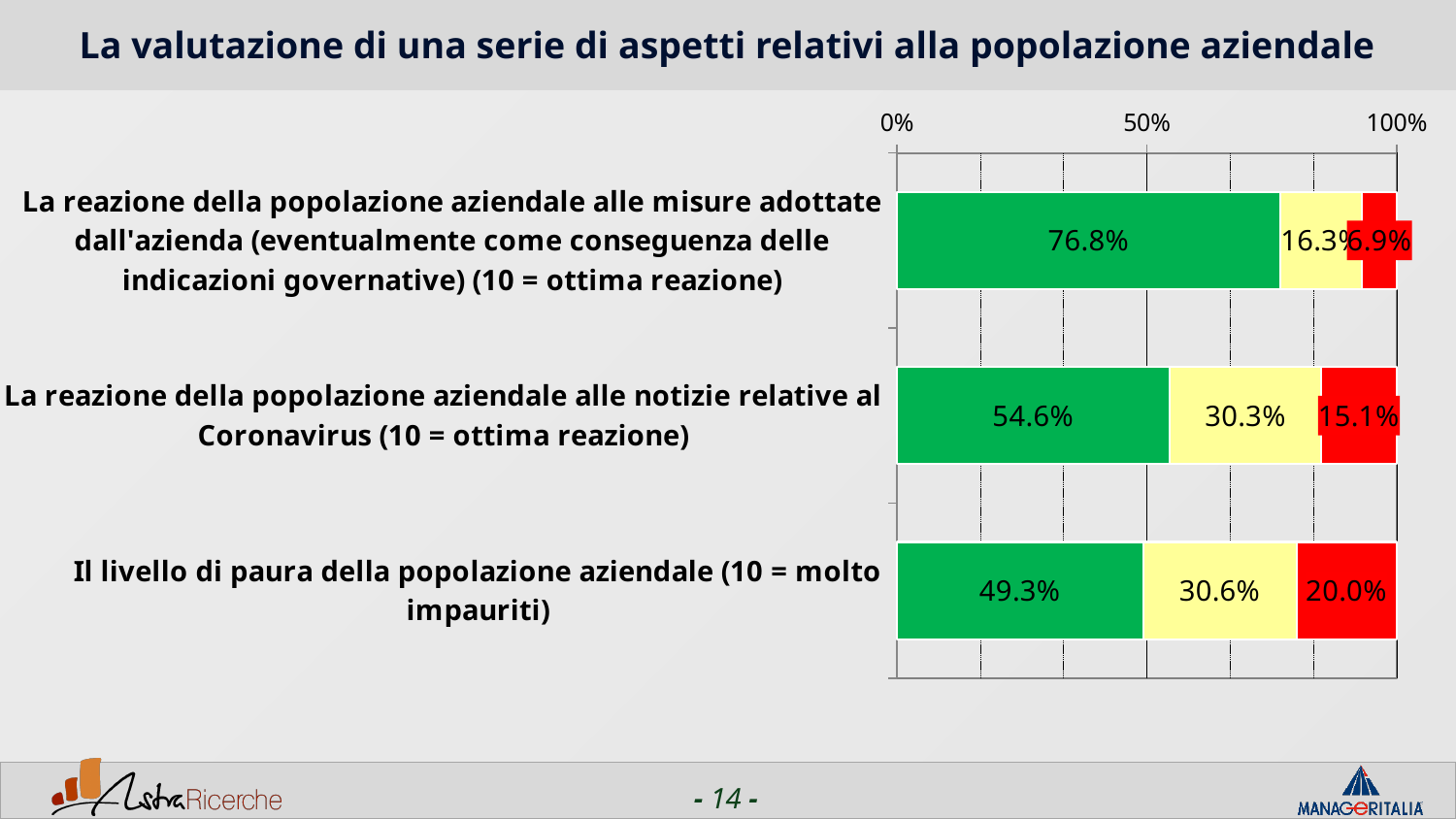
Which category has the lowest red segment value? La reazione della popolazione aziendale alle misure adottate dall'azienda How many categories (bars) does the chart show? 3 What is the difference between the green segment values for "La reazione della popolazione aziendale alle notizie relative al Coronavirus" and "Il livello di paura della popolazione aziendale"? 5.3% What is the value of the green segment for "La reazione della popolazione aziendale alle misure adottate dall'azienda"? 76.8% What is the value of the yellow segment for "La reazione della popolazione aziendale alle notizie relative al Coronavirus"? 30.3% Which is larger: the red segment for "La reazione della popolazione aziendale alle notizie relative al Coronavirus" or the red segment for "Il livello di paura della popolazione aziendale"? Il livello di paura della popolazione aziendale What is the value of the red segment for "La reazione della popolazione aziendale alle misure adottate dall'azienda"? 6.9% Which category has the highest green segment value? La reazione della popolazione aziendale alle misure adottate dall'azienda What is the value of the red segment for "Il livello di paura della popolazione aziendale"? 20.0% What is the title of the slide? La valutazione di una serie di aspetti relativi alla popolazione aziendale Is the green segment value for "Il livello di paura della popolazione aziendale" greater or less than 50%? less What kind of chart is shown on the slide? bar chart